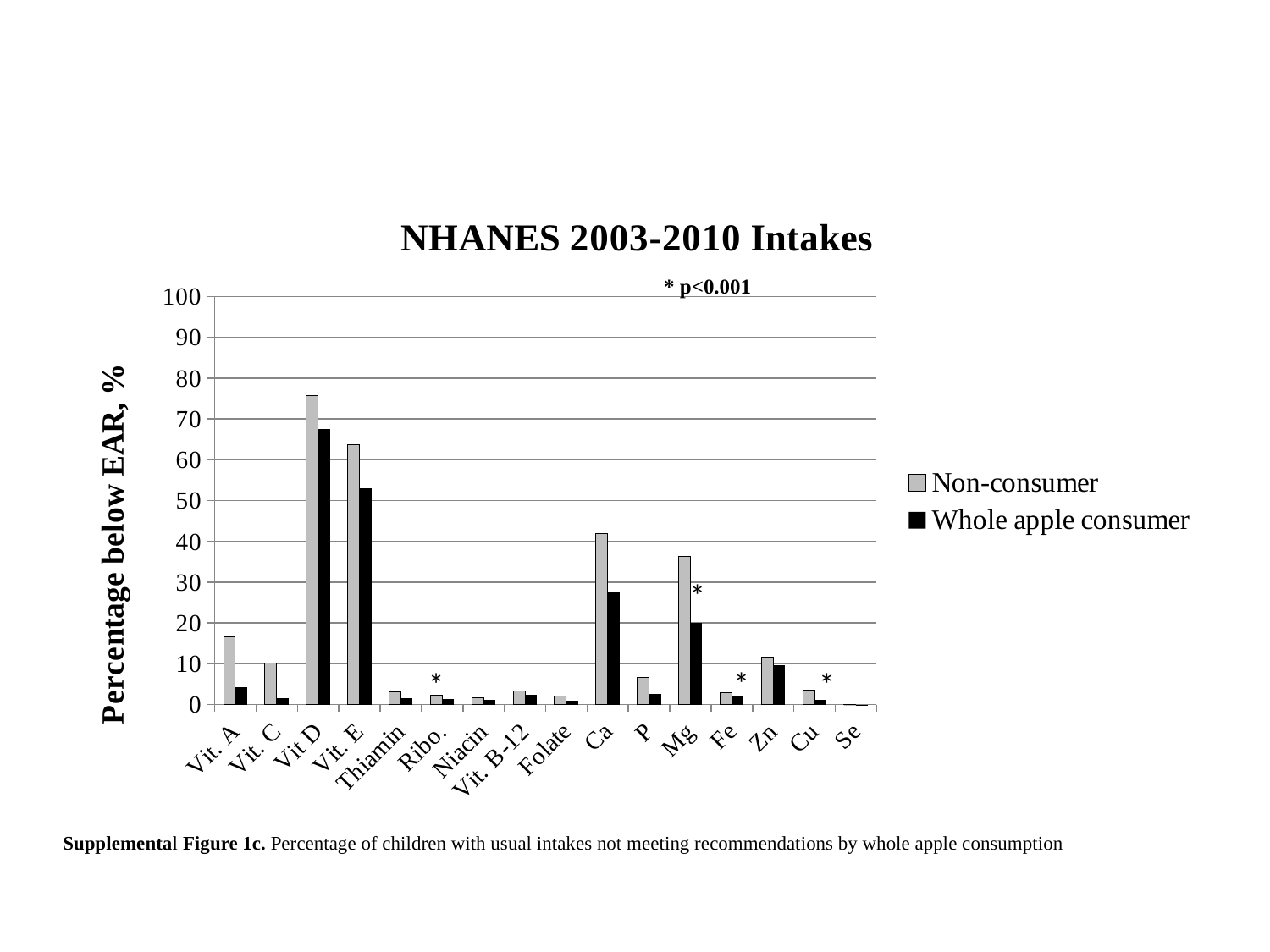
How many series does the legend list? 2 Is the Non-consumer value for Vit D greater or less than 70? greater Which nutrient has the highest Non-consumer value? Vit D Which nutrient has the lowest Non-consumer value? Se For Ca, which series has the larger value, Non-consumer or Whole apple consumer? Non-consumer How many nutrient categories are shown on the x axis? 16 Is the Whole apple consumer value for Vit D greater or less than 70? less What kind of chart is shown on the slide? Bar chart Which nutrient has the highest Whole apple consumer value? Vit D Is the Non-consumer value for Ca greater or less than 40? greater What is the title of the chart? NHANES 2003-2010 Intakes